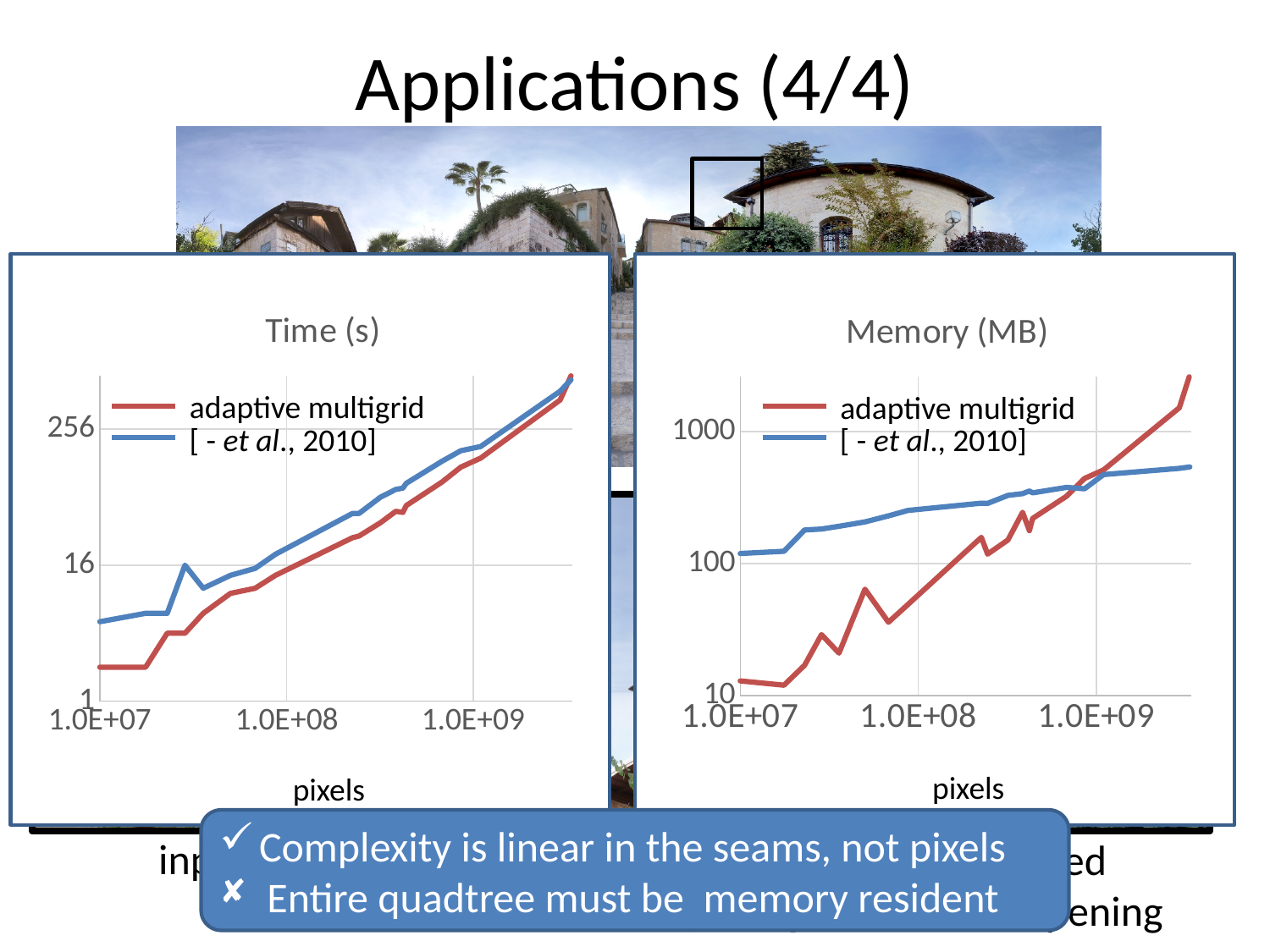
In the "Time (s)" chart, is the value for adaptive multigrid at 1.0E+07 pixels greater or less than 16? less In the "Time (s)" chart, is the value for adaptive multigrid at 1.0E+09 pixels greater or less than 16? greater In the "Time (s)" chart, what colour is the line for adaptive multigrid? red In the "Memory (MB)" chart, which series has the larger value at the rightmost point, adaptive multigrid or [ - et al., 2010]? adaptive multigrid In the "Time (s)" chart, which series has the larger value at 1.0E+08 pixels, adaptive multigrid or [ - et al., 2010]? [ - et al., 2010] In the "Time (s)" chart, do the values for adaptive multigrid rise or fall as pixels increase along the x axis? rise What kind of chart is the "Time (s)" chart? line chart In the "Memory (MB)" chart, do the values for [ - et al., 2010] rise or fall as pixels increase along the x axis? rise What is the x-axis label of the "Memory (MB)" chart? pixels In the "Memory (MB)" chart, is the value for [ - et al., 2010] at 1.0E+09 pixels greater or less than 1000? less How many series does the legend of the "Memory (MB)" chart list? 2